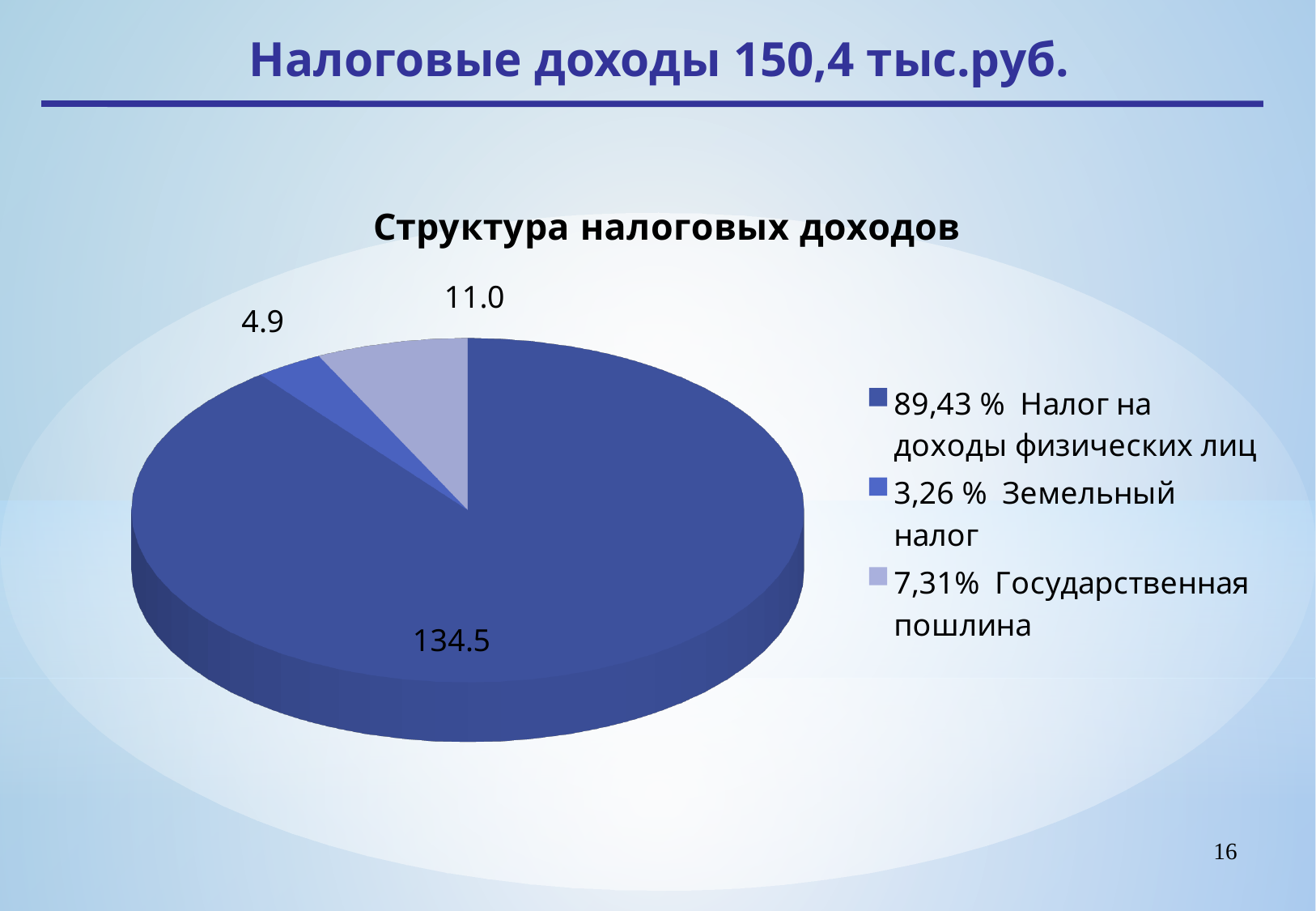
Which category has the largest slice? Налог на доходы физических лиц What is the value for Земельный налог? 4.9 How many slices does the pie chart have? 3 What is the title of the chart? Структура налоговых доходов What kind of chart is shown on the slide? pie chart What is the difference between the values for Налог на доходы физических лиц and Государственная пошлина? 123.5 What is the value for Налог на доходы физических лиц? 134.5 How many entries does the legend list? 3 What share of the pie does Государственная пошлина represent, according to the legend? 7,31% Which category has the smallest slice? Земельный налог What is the value for Государственная пошлина? 11.0 Which is larger, the value for Государственная пошлина or the value for Земельный налог? Государственная пошлина